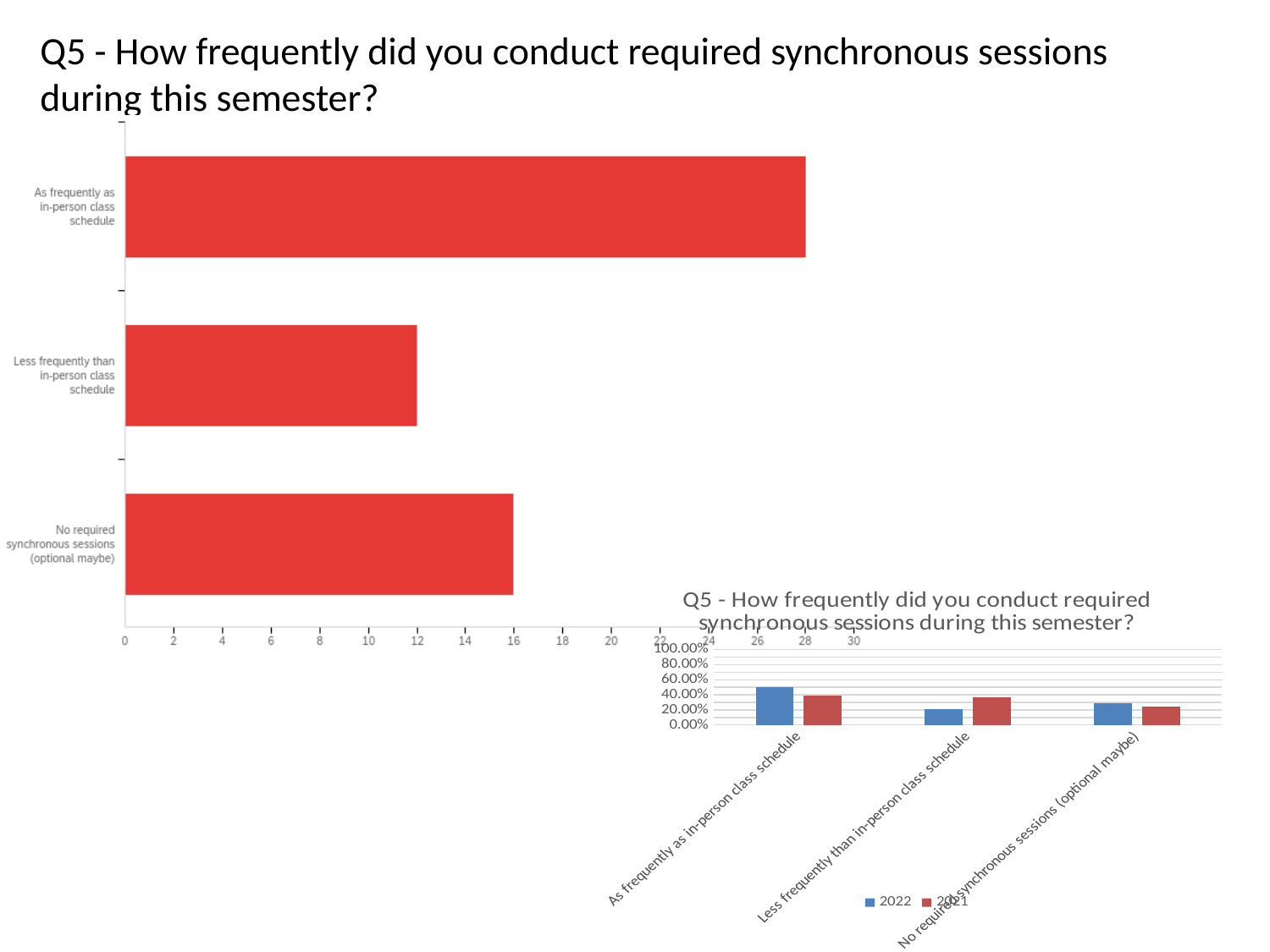
In the large horizontal bar chart on the left, what is the value for 'No required synchronous sessions (optional maybe)'? 16 What type of chart is the large chart on the left of the slide? Bar chart In the large horizontal bar chart on the left, which category has the lowest value? Less frequently than in-person class schedule In the large horizontal bar chart on the left, which category has the highest value? As frequently as in-person class schedule In the small chart at the bottom right, is the 2022 value for 'As frequently as in-person class schedule' greater or less than 40.00%? greater In the large horizontal bar chart on the left, what is the value for 'Less frequently than in-person class schedule'? 12 In the small chart titled 'Q5 - How frequently did you conduct required synchronous sessions during this semester?' at the bottom right, how many series does the legend list? 2 In the small chart at the bottom right, which series is larger for 'Less frequently than in-person class schedule', 2022 or 2021? 2021 In the large horizontal bar chart on the left, what is the value for 'As frequently as in-person class schedule'? 28 In the small chart at the bottom right, which series is larger for 'As frequently as in-person class schedule', 2022 or 2021? 2022 In the large horizontal bar chart on the left, how many categories are shown? 3 In the large horizontal bar chart on the left, what is the difference between 'As frequently as in-person class schedule' and 'No required synchronous sessions (optional maybe)'? 12